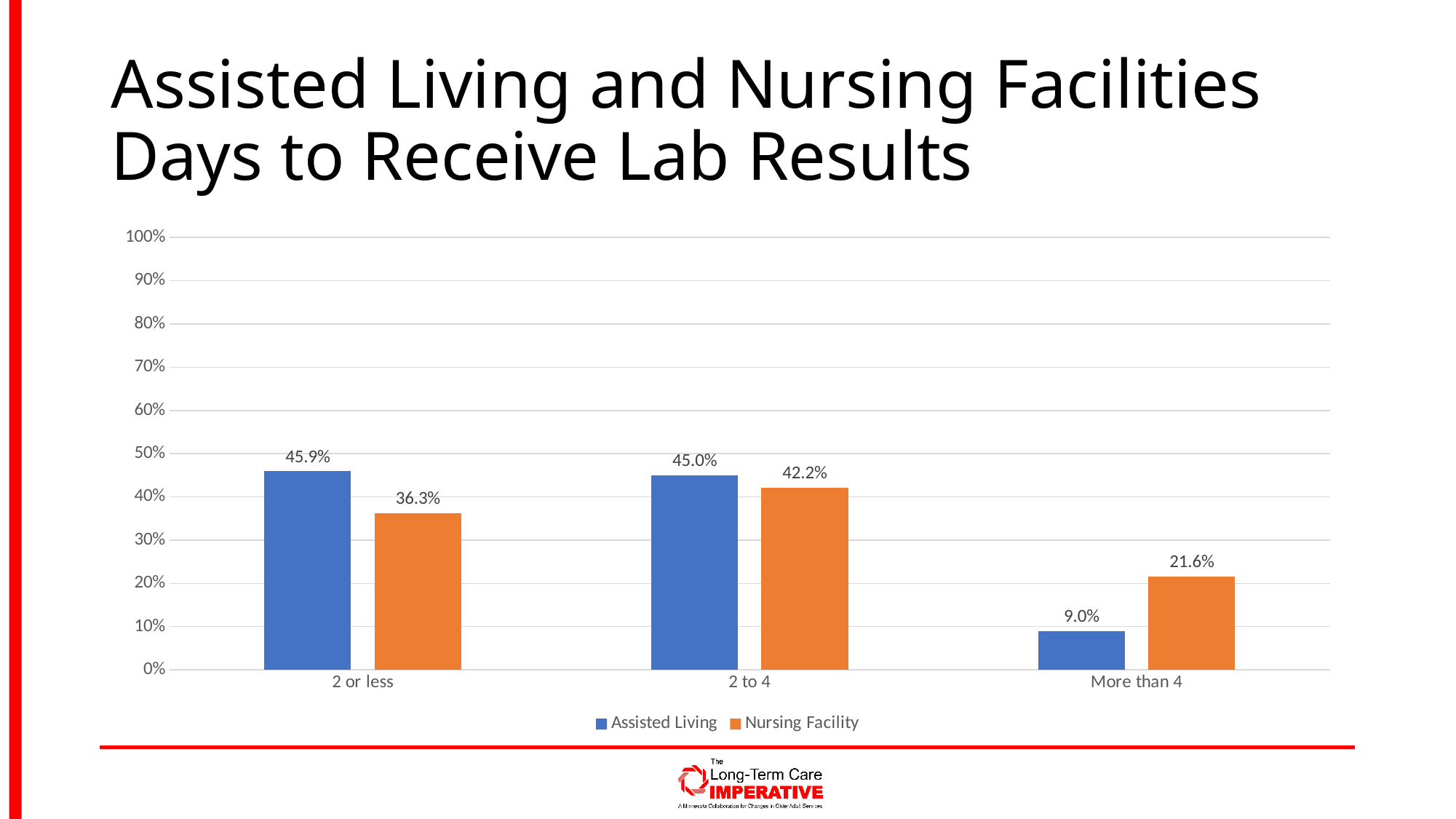
How many series does the legend list? 2 What kind of chart is shown on the slide? Bar chart Which category has the highest Nursing Facility value? 2 to 4 How many categories are shown on the x axis? 3 What is the Assisted Living value for the '2 or less' category? 45.9% What is the Nursing Facility value for the 'More than 4' category? 21.6% What is the difference between the Nursing Facility and Assisted Living values for 'More than 4'? 12.6% What is the difference between the Assisted Living and Nursing Facility values for '2 or less'? 9.6% Which category has the lowest Assisted Living value? More than 4 Is the Assisted Living value for '2 to 4' greater or less than 40%? greater What is the Nursing Facility value for the '2 to 4' category? 42.2% For the 'More than 4' category, which series has the larger value, Assisted Living or Nursing Facility? Nursing Facility